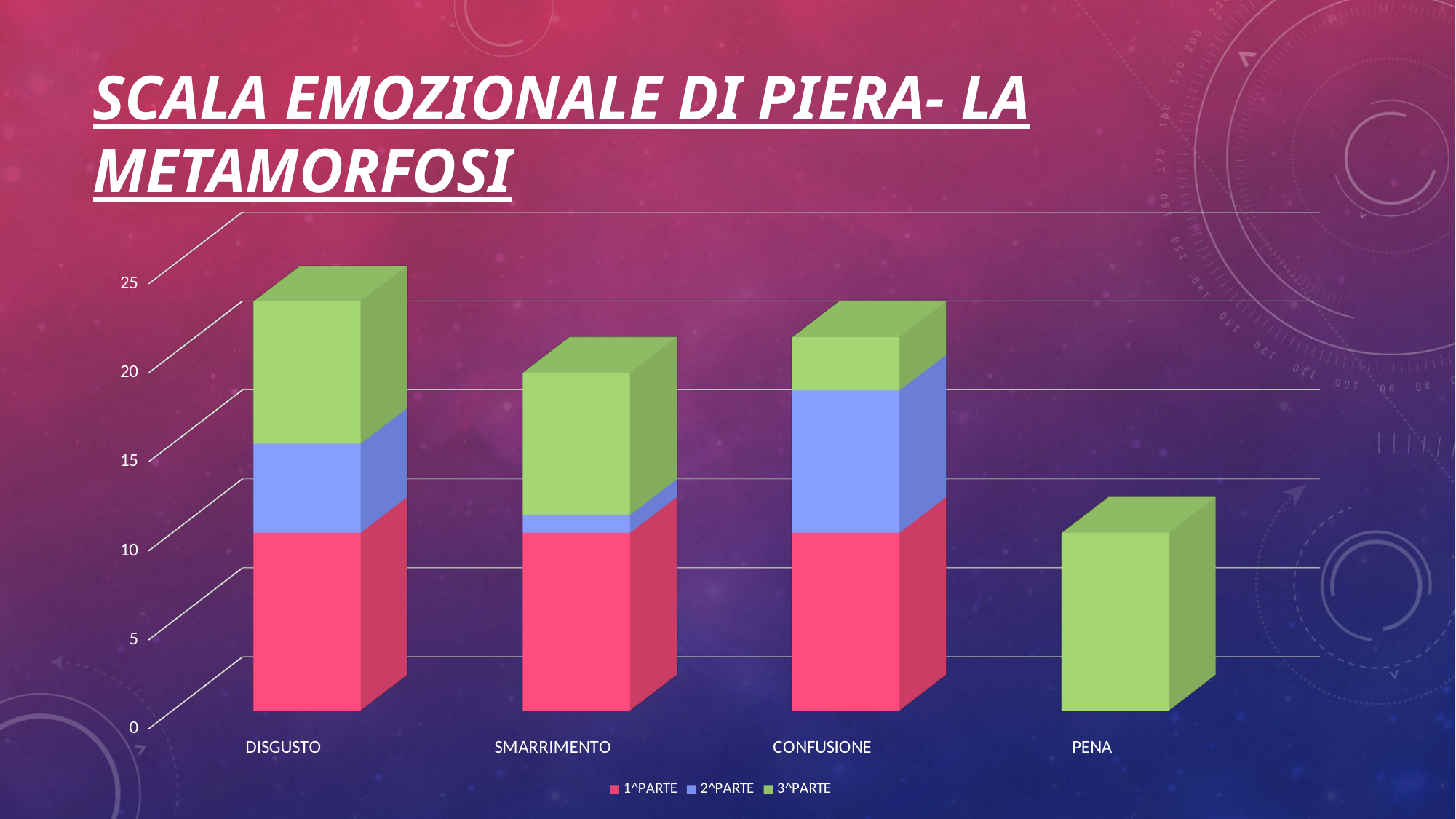
Is the total stacked value for SMARRIMENTO greater or less than 15? greater What is the title of the slide containing the chart? SCALA EMOZIONALE DI PIERA- LA METAMORFOSI Which series is shown in green in the legend? 3^PARTE What kind of chart is shown on the slide? bar chart Which category has the tallest stacked bar? DISGUSTO Which stacked bar is taller, DISGUSTO or SMARRIMENTO? DISGUSTO How many series does the legend list? 3 How many emotion categories are shown on the x axis? 4 Is the total stacked value for PENA greater or less than 15? less Which category has the shortest stacked bar? PENA Which category has the larger 2^PARTE segment, CONFUSIONE or SMARRIMENTO? CONFUSIONE Is the total stacked value for DISGUSTO greater or less than 20? greater